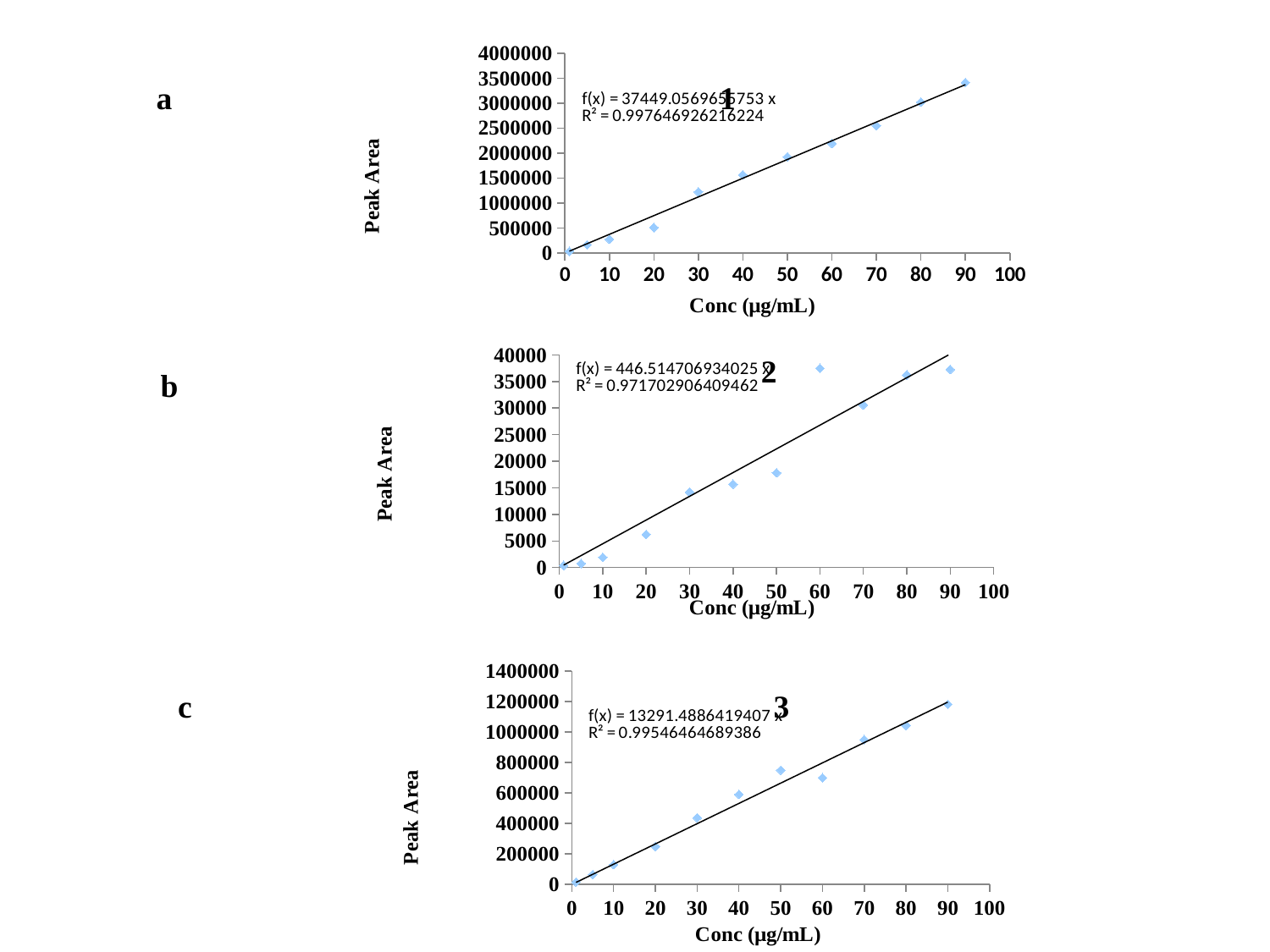
In chart a (the top chart), is the Peak Area at 30 µg/mL greater or less than 1000000? greater In chart a (the top chart), at which concentration is the Peak Area highest? 90 What is the x-axis title of chart c (the bottom chart)? Conc (µg/mL) In chart a (the top chart), do the Peak Area values rise or fall as Conc (µg/mL) increases? rise In chart c (the bottom chart), is the Peak Area at 70 µg/mL greater or less than 1000000? less In chart a (the top chart), is the Peak Area at 90 µg/mL greater or less than 3000000? greater What kind of chart is chart a (the top chart)? scatter chart What R² value is shown on chart a (the top chart)? 0.997646926216224 In chart c (the bottom chart), which has the larger Peak Area: 50 µg/mL or 60 µg/mL? 50 µg/mL In chart b (the middle chart), which has the larger Peak Area: 60 µg/mL or 70 µg/mL? 60 µg/mL